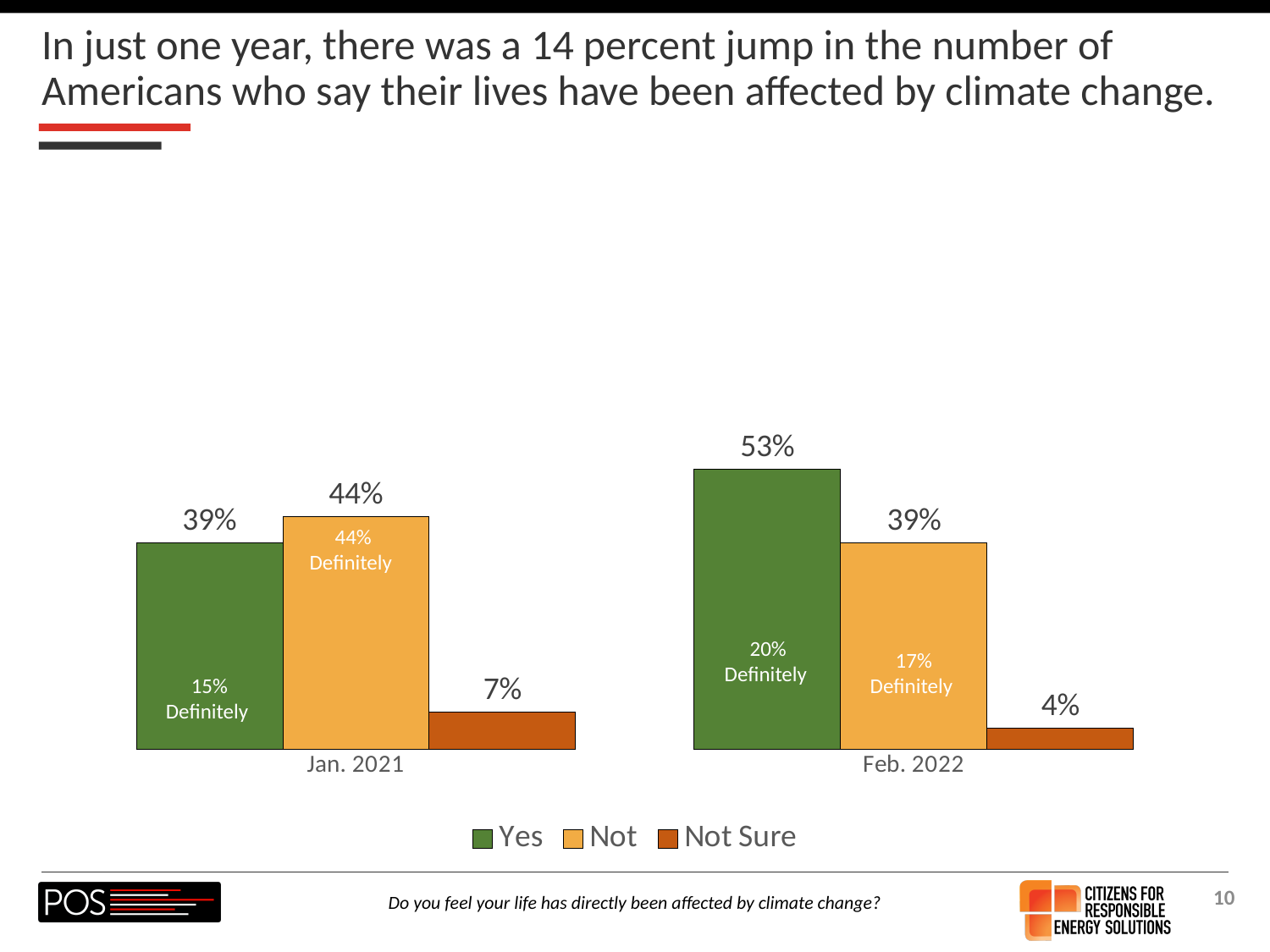
What is the difference between the "Not" values for Jan. 2021 and Feb. 2022? 5 Which response had the lowest percentage in Feb. 2022? Not Sure What percentage of Feb. 2022 respondents said their life has "Definitely" been affected? 20% What percentage of Americans answered "Yes" in Feb. 2022? 53% What is the "Yes" value for Jan. 2021? 39% Which is larger in Feb. 2022, the "Yes" value or the "Not" value? Yes What kind of chart is shown on the slide? Bar chart By how many percentage points did the "Yes" response increase from Jan. 2021 to Feb. 2022? 14 What percentage answered "Not" in Jan. 2021? 44% Which response had the highest percentage in Jan. 2021? Not How many series does the legend list? 3 What is the "Not Sure" value for Feb. 2022? 4%